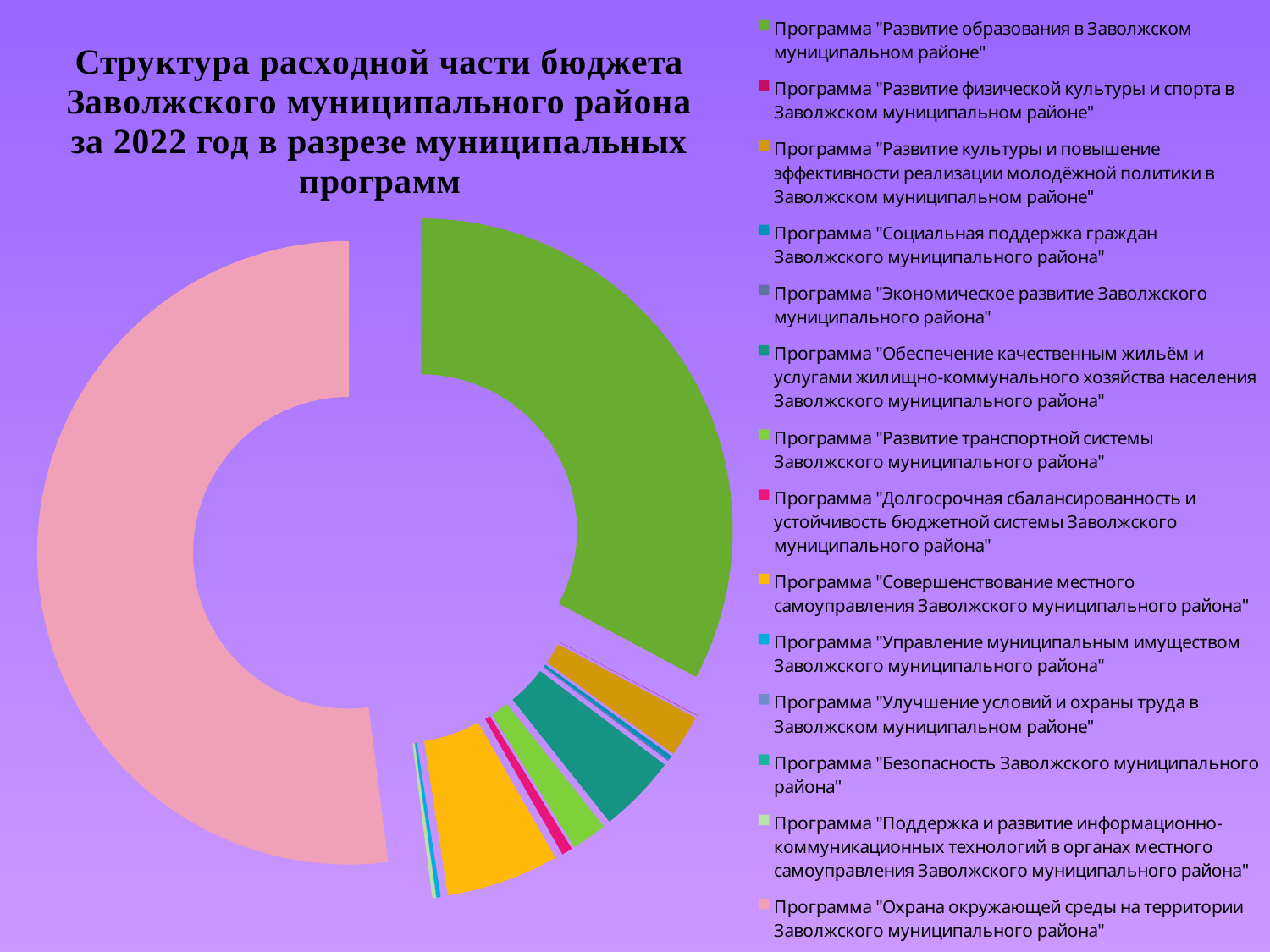
How many programme entries does the chart legend list? 14 Which slice is larger: "Развитие образования в Заволжском муниципальном районе" or "Совершенствование местного самоуправления Заволжского муниципального района"? Развитие образования в Заволжском муниципальном районе Which slice is larger: "Развитие культуры и повышение эффективности реализации молодёжной политики в Заволжском муниципальном районе" or "Социальная поддержка граждан Заволжского муниципального района"? Развитие культуры и повышение эффективности реализации молодёжной политики в Заволжском муниципальном районе What is the title of the chart? Структура расходной части бюджета Заволжского муниципального района за 2022 год в разрезе муниципальных программ Which colour represents the programme "Развитие образования в Заволжском муниципальном районе"? Green Which slice is larger: "Совершенствование местного самоуправления Заволжского муниципального района" or "Долгосрочная сбалансированность и устойчивость бюджетной системы Заволжского муниципального района"? Совершенствование местного самоуправления Заволжского муниципального района What kind of chart is shown on the slide? Doughnut (pie) chart